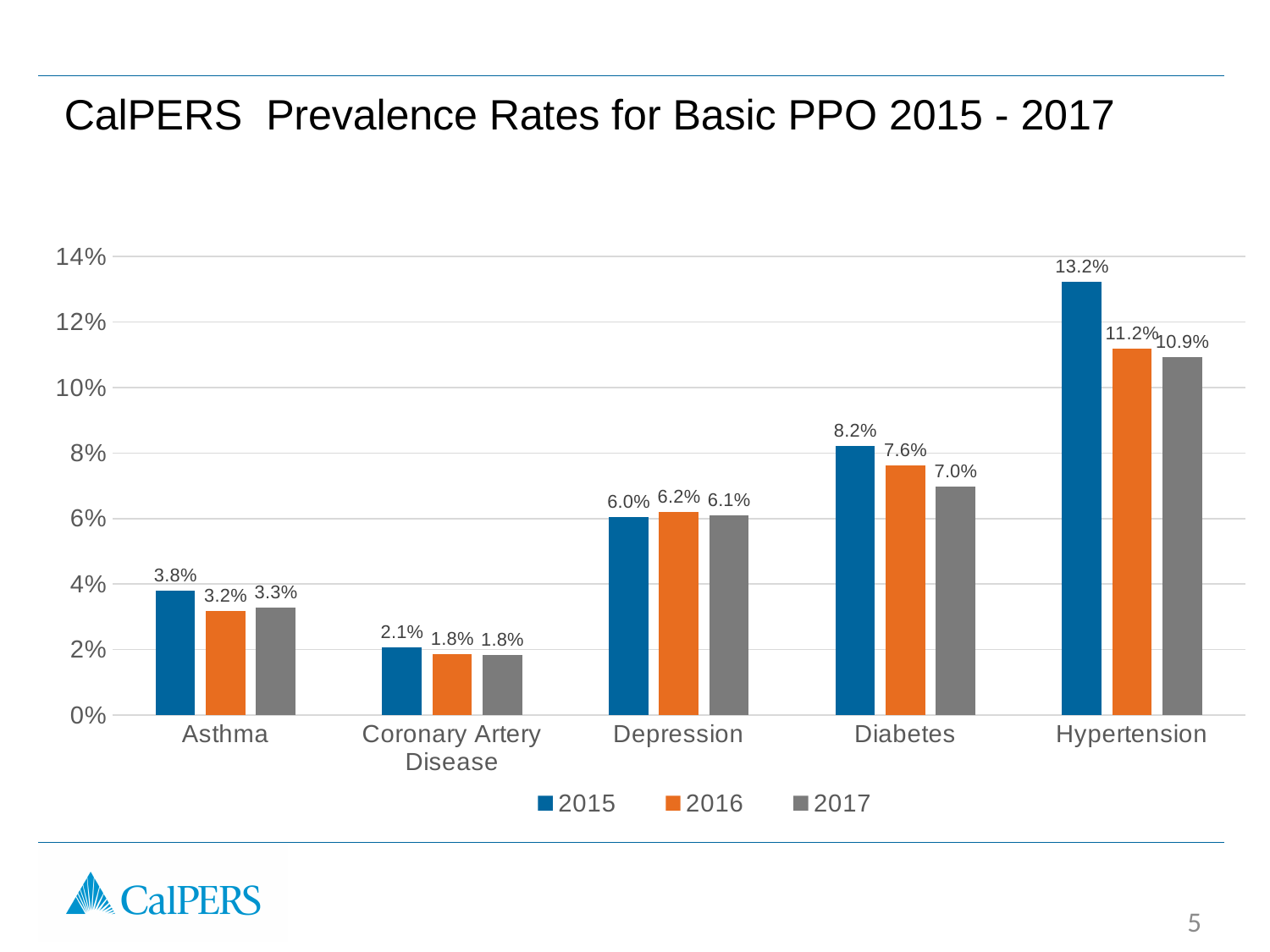
What is the prevalence rate for Coronary Artery Disease in 2016? 1.8% What is the prevalence rate for Diabetes in 2017? 7.0% Is the 2016 prevalence rate for Diabetes greater or less than 8%? less How many series does the legend list? 3 What is the prevalence rate for Hypertension in 2015? 13.2% Which condition has the lowest prevalence rate in 2015? Coronary Artery Disease How many conditions are shown on the x axis? 5 Which condition has the highest prevalence rate in 2017? Hypertension What kind of chart is shown on the slide? bar chart Does the prevalence rate for Diabetes rise or fall from 2015 to 2017? fall Which is larger: the 2015 prevalence rate for Asthma or the 2015 prevalence rate for Depression? Depression What is the difference between the 2015 and 2017 prevalence rates for Hypertension? 2.3%